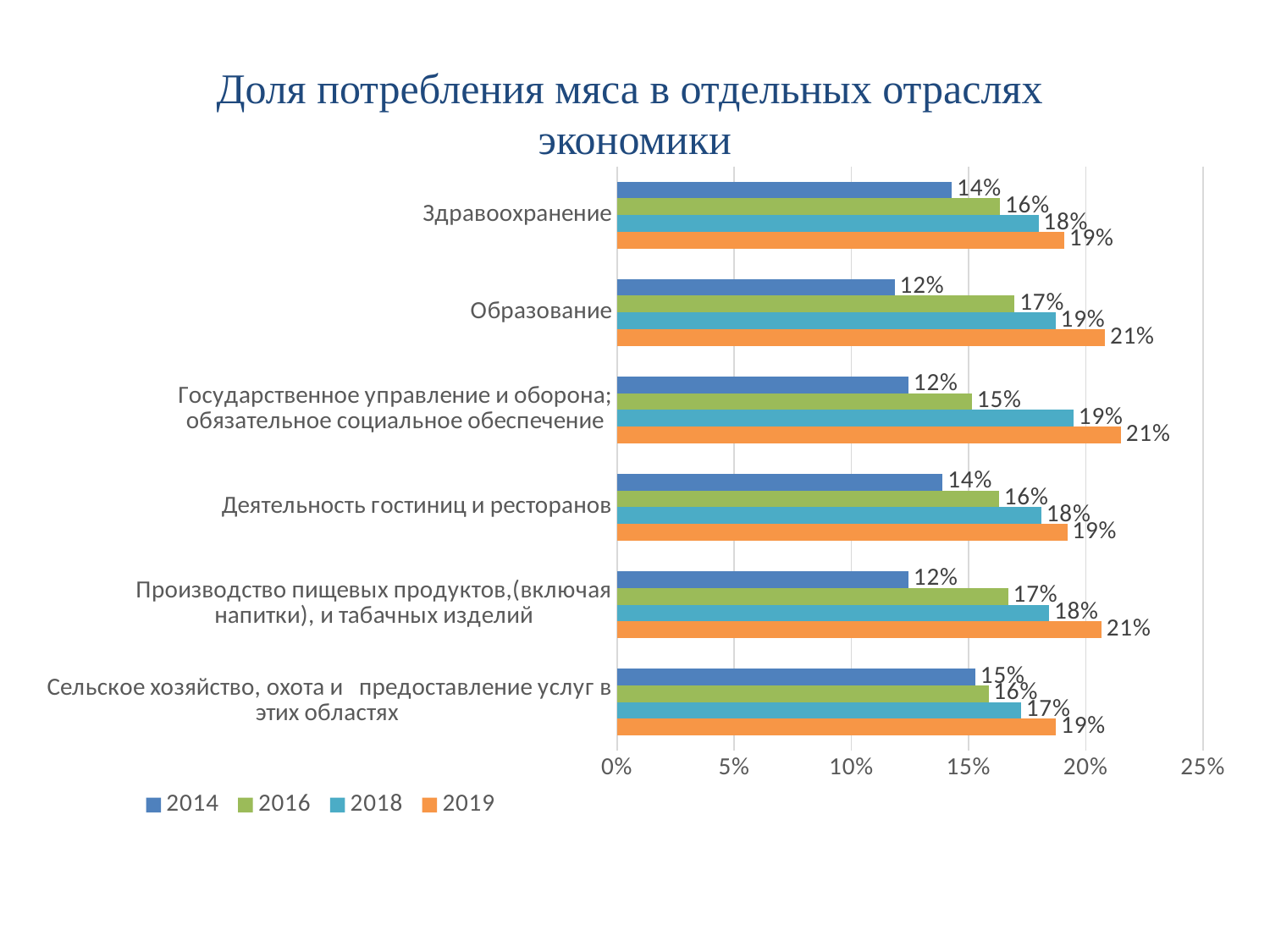
How many categories are shown on the chart? 6 Which category has the highest value for 2014? Сельское хозяйство, охота и предоставление услуг в этих областях What is the value for Сельское хозяйство, охота и предоставление услуг в этих областях in 2018? 17% Is the 2019 value for Государственное управление и оборона; обязательное социальное обеспечение greater or less than 20%? greater Which is larger: the 2014 value for Здравоохранение or the 2014 value for Образование? Здравоохранение How many series does the legend list? 4 What is the difference between the 2019 and 2014 values for Образование? 9 percentage points What is the value for Здравоохранение in 2014? 14% What is the value for Производство пищевых продуктов,(включая напитки), и табачных изделий in 2016? 17% What kind of chart is shown on the slide? Bar chart What is the value for Образование in 2019? 21% Which category has the lowest value for 2016? Государственное управление и оборона; обязательное социальное обеспечение